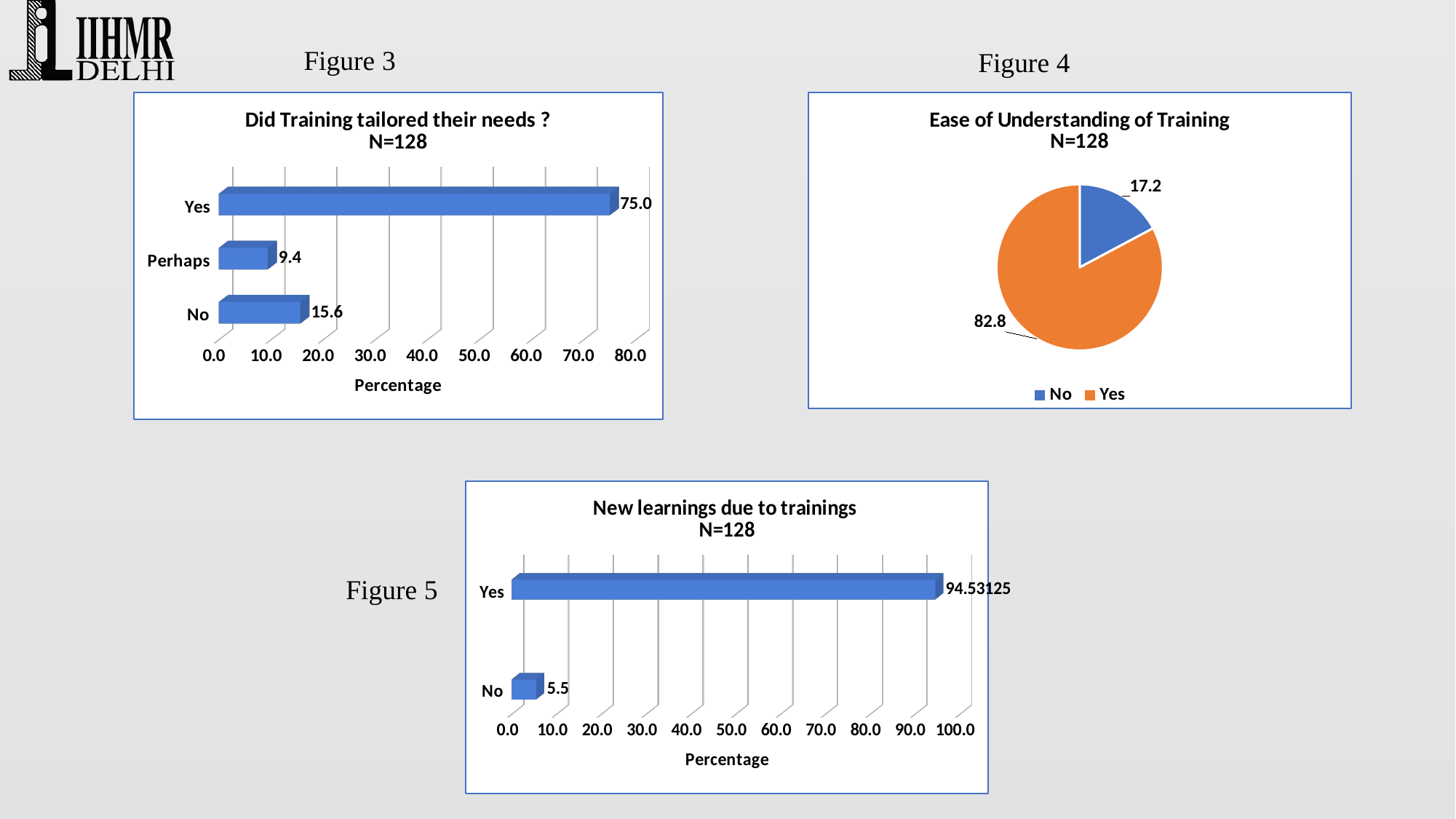
In the 'Did Training tailored their needs ?' chart, which category has the lowest value? Perhaps In the 'Ease of Understanding of Training' pie chart, what is the value for Yes? 82.8 In the 'Did Training tailored their needs ?' chart, what is the value for Yes? 75.0 In the 'Did Training tailored their needs ?' chart, how many categories are shown? 3 In the 'New learnings due to trainings' chart, what is the value for Yes? 94.53125 In the 'Did Training tailored their needs ?' chart, what is the value for Perhaps? 9.4 In the 'Ease of Understanding of Training' pie chart, which slice is larger, No or Yes? Yes What kind of chart is 'Ease of Understanding of Training'? Pie chart In the 'New learnings due to trainings' chart, what is the value for No? 5.5 What kind of chart is 'New learnings due to trainings'? Bar chart How many entries does the legend of the 'Ease of Understanding of Training' chart list? 2 In the 'Did Training tailored their needs ?' chart, what is the difference between the values for No and Perhaps? 6.2